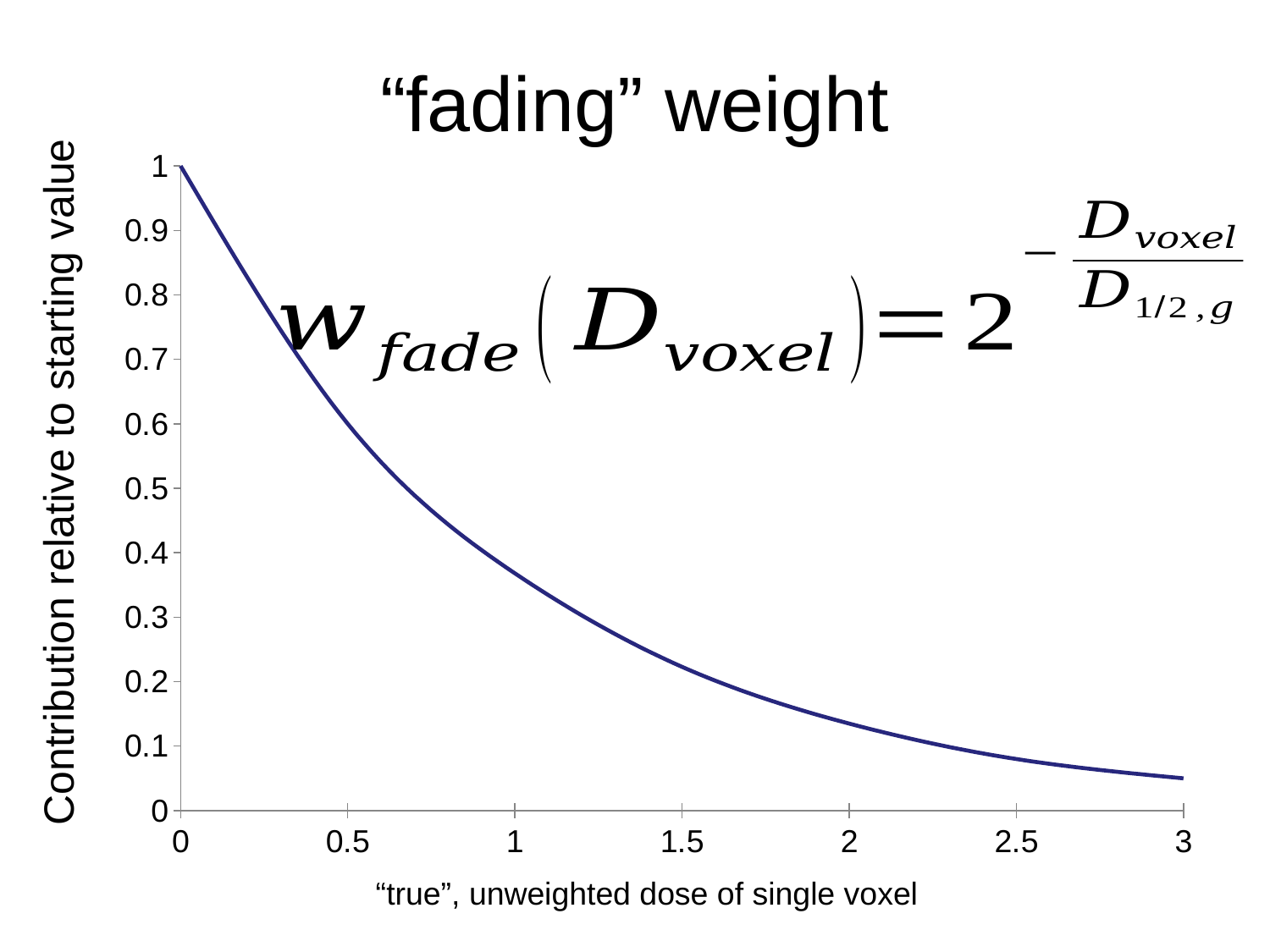
What is the title of the chart? "fading" weight At which dose value on the x axis is the curve highest? 0 What kind of chart is shown on the slide? line chart Is the value of the curve at a dose of 2 greater or less than 0.3? less What is the label of the y axis? Contribution relative to starting value Is the value of the curve at a dose of 1 greater or less than 0.6? less Is the value of the curve at a dose of 1.5 greater or less than 0.4? less What is the contribution relative to starting value at a dose of 0? 1 At which dose value on the x axis is the curve lowest? 3 Does the curve rise or fall as the dose increases along the x axis? fall